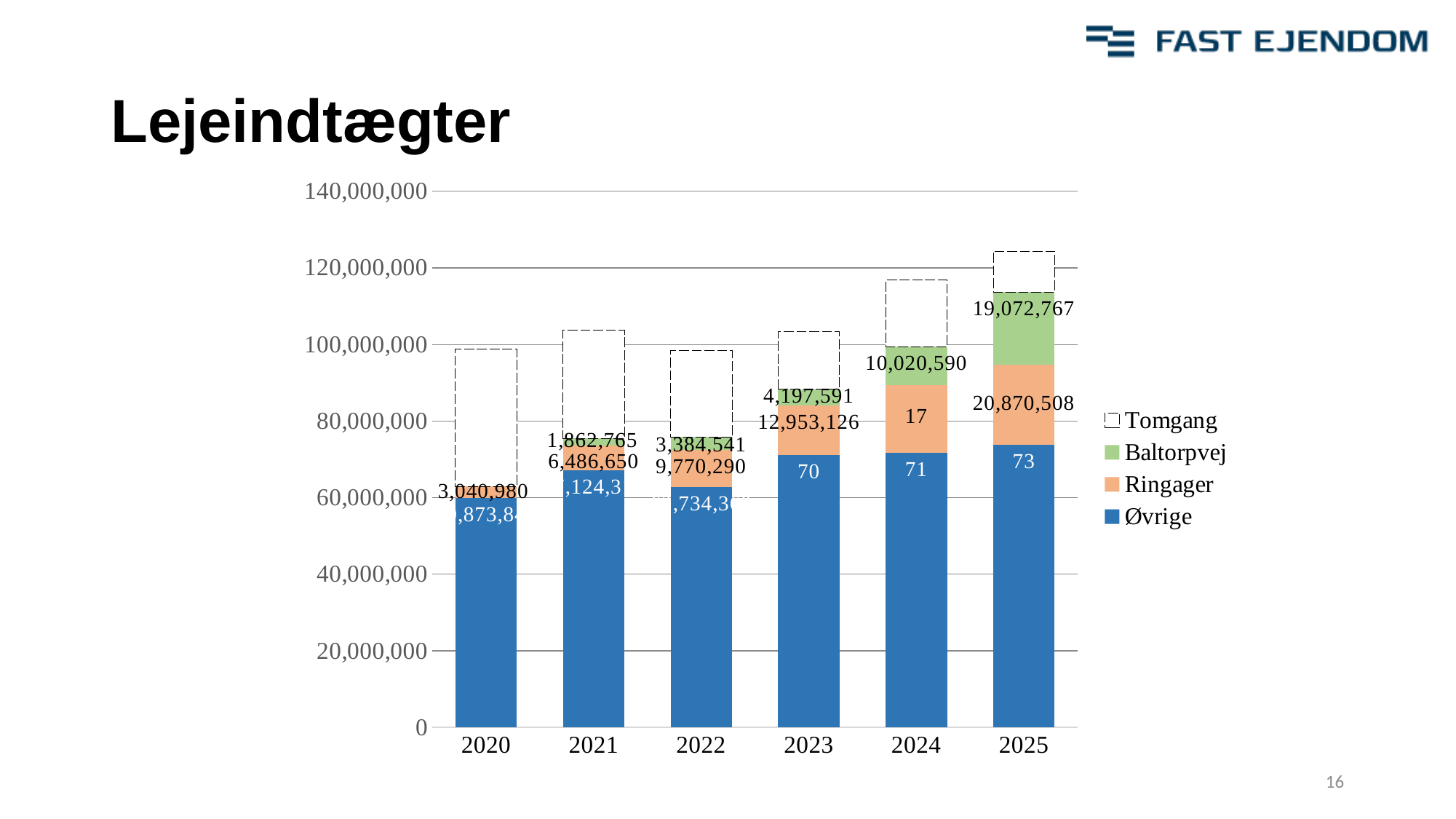
What is the value for Baltorpvej in 2021? 1,862,765 Which is larger, Baltorpvej in 2024 or Baltorpvej in 2023? Baltorpvej in 2024 What is the difference between the Ringager values in 2025 and 2023? 7,917,382 What is the value for Baltorpvej in 2025? 19,072,767 What is the value for Ringager in 2020? 3,040,980 What is the value for Ringager in 2023? 12,953,126 What kind of chart is shown on the slide? Stacked bar chart Is the value for Øvrige in 2025 greater or less than 60,000,000? greater In which year is the Baltorpvej value highest? 2025 How many series does the legend list? 4 What is the value for Ringager in 2022? 9,770,290 How many years are shown on the x axis? 6